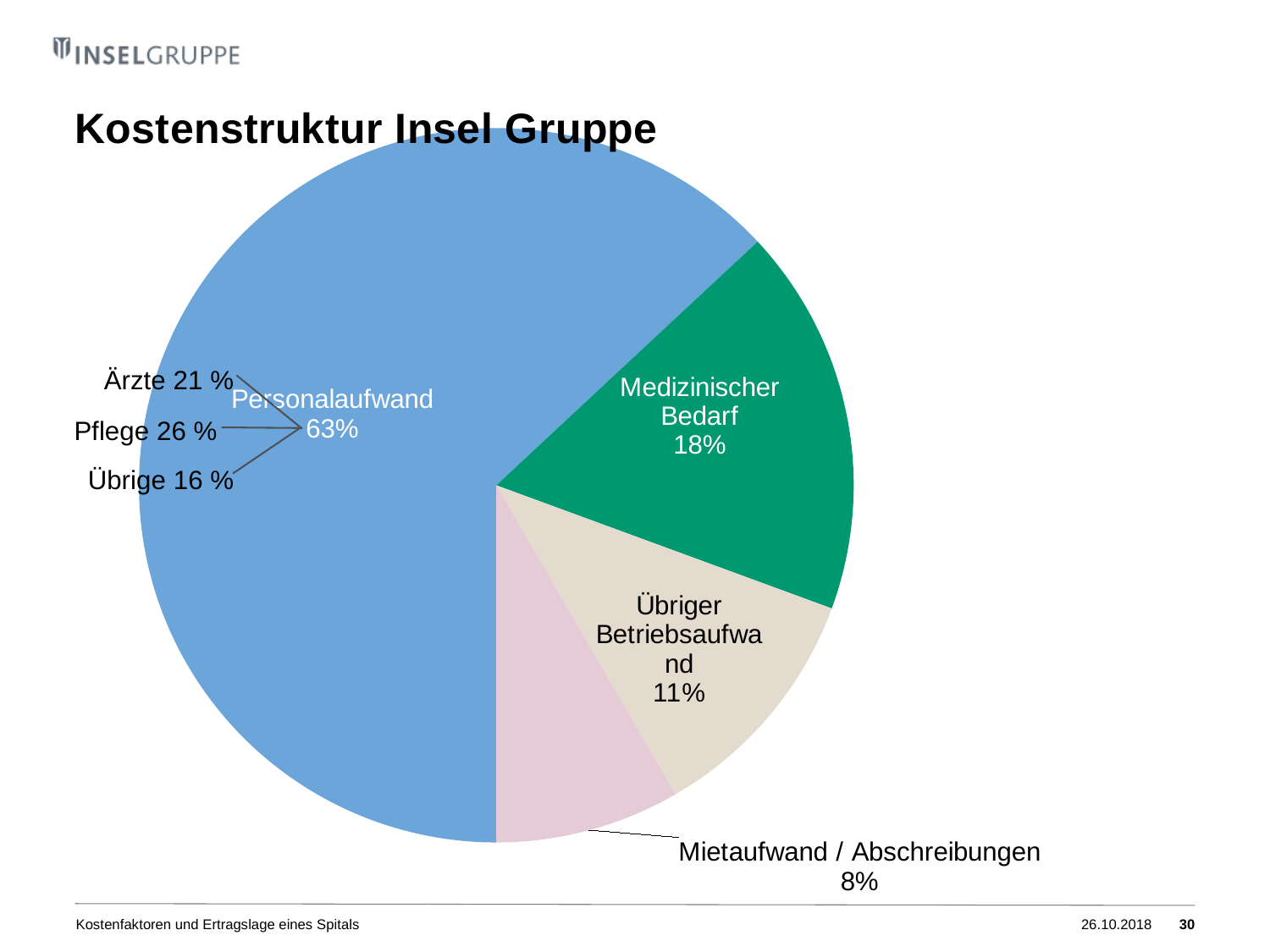
What is the value for Übriger Betriebsaufwand? 11% How many slices does the pie chart have? 4 What is the difference between Personalaufwand and Medizinischer Bedarf? 45% What is the title of the chart? Kostenstruktur Insel Gruppe According to the annotation next to the Personalaufwand slice, what share is attributed to Pflege? 26 % Which is larger, Übriger Betriebsaufwand or Mietaufwand / Abschreibungen? Übriger Betriebsaufwand What kind of chart is shown on the slide? pie chart What is the value for Medizinischer Bedarf? 18% What share of the pie does Personalaufwand represent? 63% What is the value for Mietaufwand / Abschreibungen? 8% Which slice of the pie is the largest? Personalaufwand Which slice of the pie is the smallest? Mietaufwand / Abschreibungen